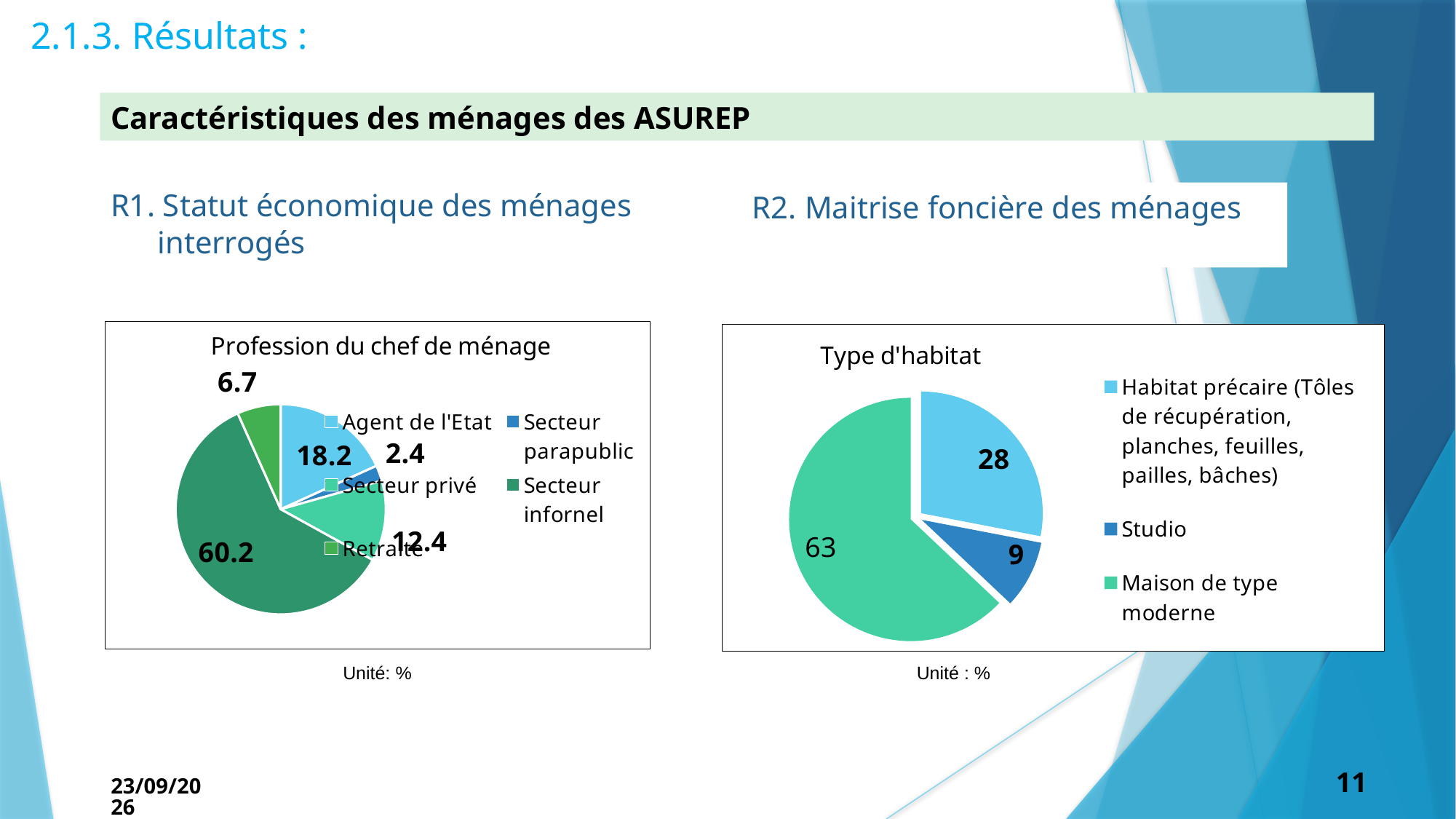
In the 'Type d'habitat' chart, what is the difference between Maison de type moderne and Habitat précaire? 35 In the 'Type d'habitat' chart, how many entries does the legend list? 3 In the 'Profession du chef de ménage' chart, which category has the smallest slice? Secteur parapublic In the 'Profession du chef de ménage' chart, what is the difference between Agent de l'Etat and Secteur privé? 5.8 In the 'Profession du chef de ménage' chart, how many categories are shown? 5 In the 'Type d'habitat' chart, which is larger: Habitat précaire or Studio? Habitat précaire In the 'Type d'habitat' chart, what is the value for Studio? 9 In the 'Profession du chef de ménage' chart, what is the value for Secteur infornel? 60.2 In the 'Profession du chef de ménage' chart, which category has the largest slice? Secteur infornel In the 'Type d'habitat' chart, which category has the largest slice? Maison de type moderne In the 'Profession du chef de ménage' chart, what is the value for Agent de l'Etat? 18.2 What type of chart is the 'Type d'habitat' chart? Pie chart